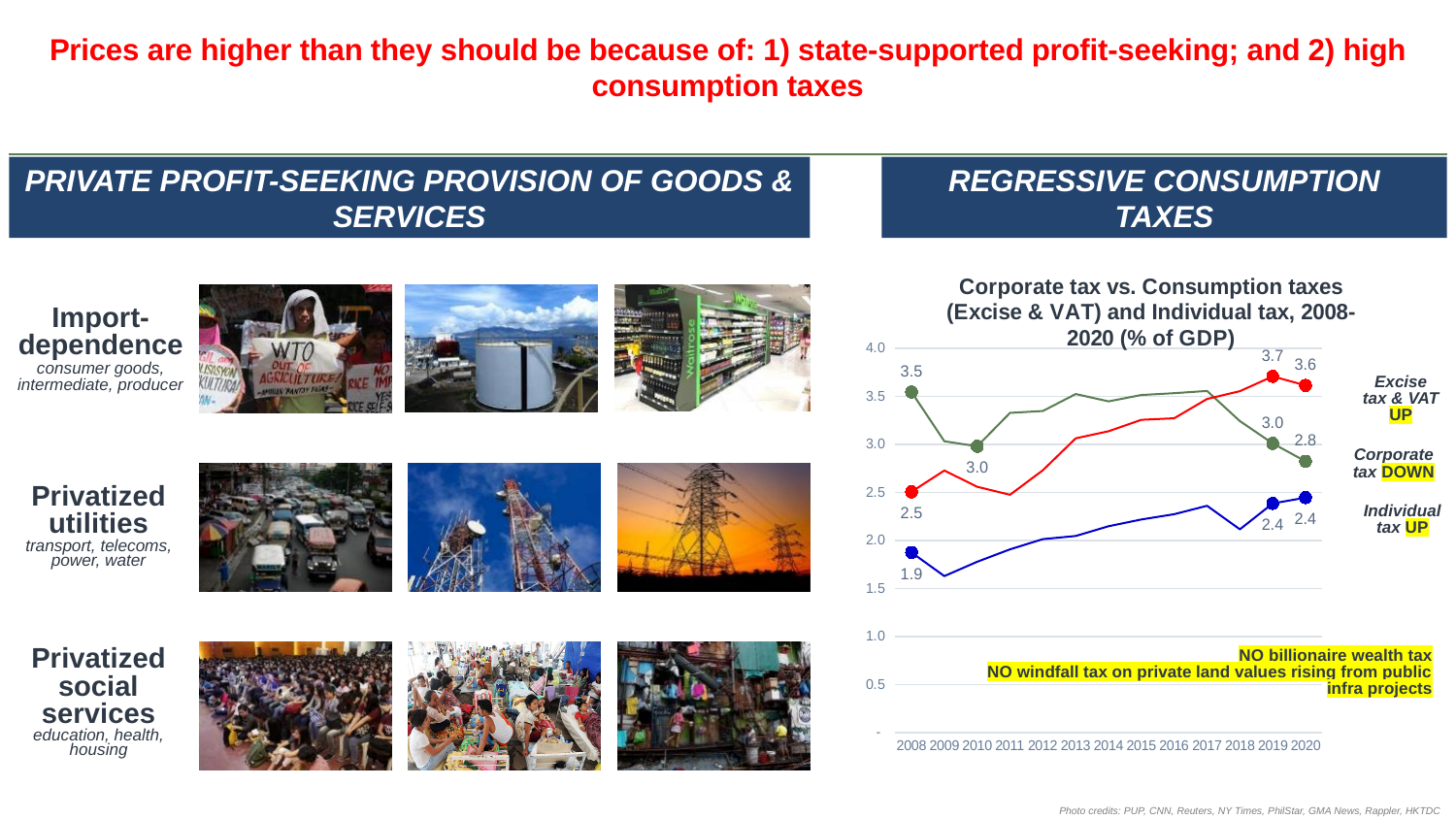
Does the corporate tax line rise or fall from 2008 to 2020? fall In 2020, which is larger: corporate tax or excise tax & VAT? Excise tax & VAT By how much did excise tax & VAT rise from 2008 to 2019? 1.2 What is the individual tax value (% of GDP) in 2008? 1.9 How many years are shown on the x axis? 13 What is the excise tax & VAT value (% of GDP) in 2020? 3.6 What is the corporate tax value (% of GDP) in 2020? 2.8 How many tax series are plotted on the chart? 3 Which series has the highest value in 2020? Excise tax & VAT What kind of chart is shown on the slide? line chart What is the corporate tax value (% of GDP) in 2008? 3.5 Is the individual tax value for 2014 greater or less than 2.5? less